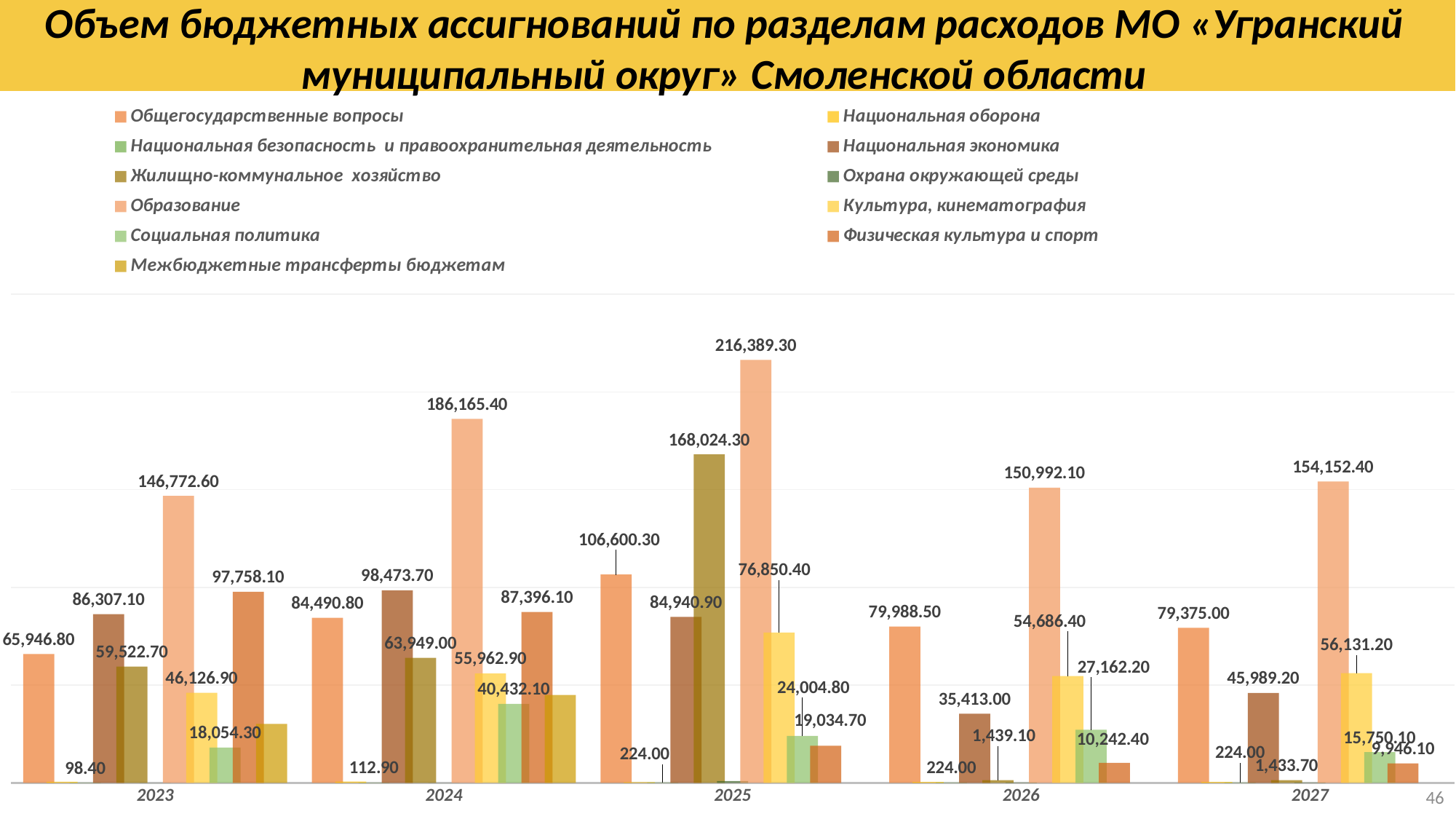
What is the value for Общегосударственные вопросы in 2024? 84,490.80 What kind of chart is shown on the slide? Bar chart What is the value for Социальная политика in 2026? 27,162.20 How many years are shown on the x axis? 5 What is the value for Жилищно-коммунальное хозяйство in 2025? 168,024.30 Does the value for Физическая культура и спорт rise or fall from 2023 to 2027? Fall What is the difference between the Образование values for 2025 and 2024? 30,223.90 How many series does the legend list? 11 In which year is the value for Образование the highest? 2025 What is the value for Образование in 2025? 216,389.30 In 2023, which is larger: Национальная экономика or Физическая культура и спорт? Физическая культура и спорт